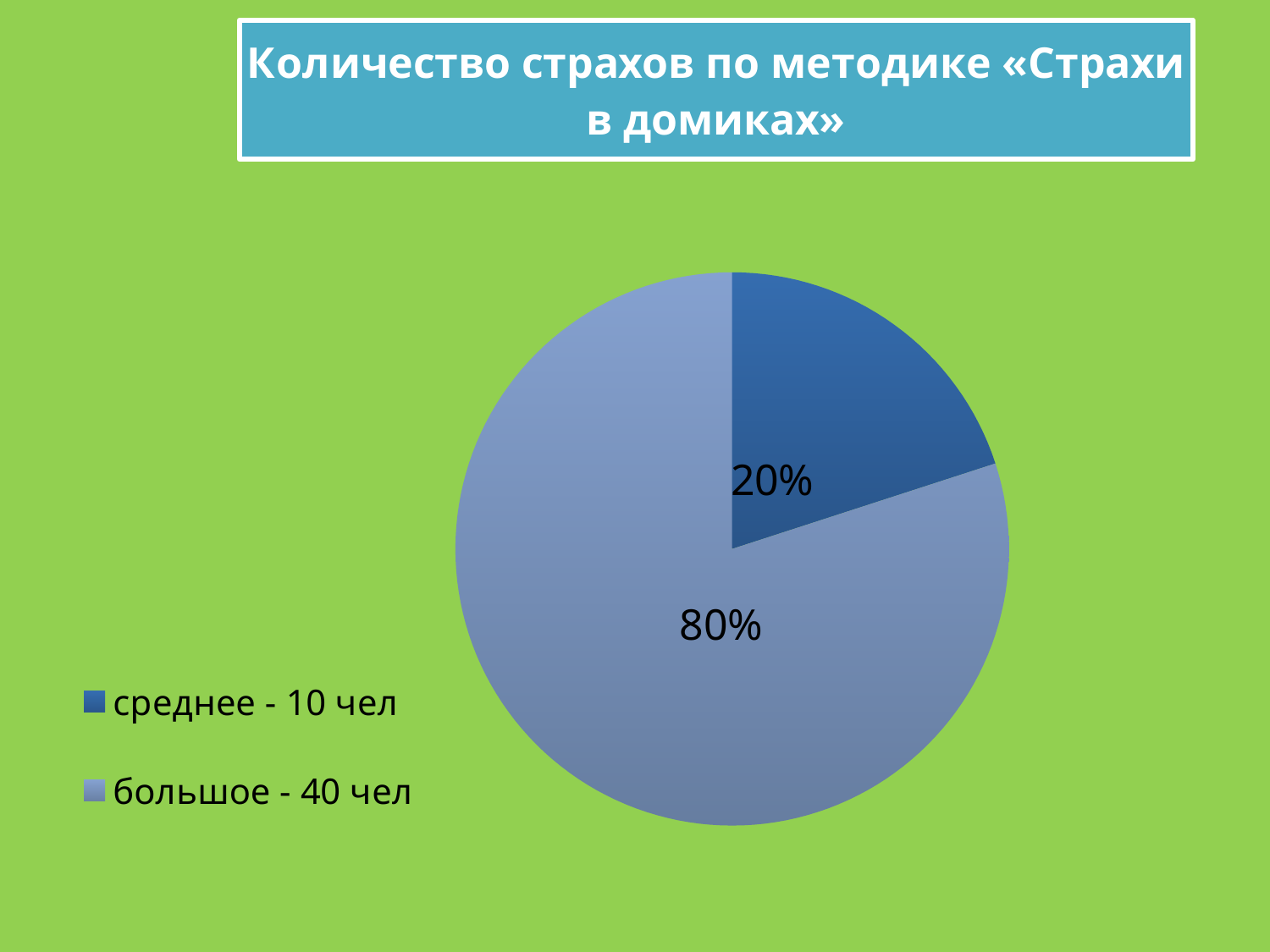
How many entries does the legend list? 2 What kind of chart is shown on the slide? pie chart Which slice is the largest in the pie chart? большое - 40 чел Is the share of the "среднее - 10 чел" slice greater or less than 50%? less What is the title of the chart on the slide? Количество страхов по методике «Страхи в домиках» What share of the pie does the slice "среднее - 10 чел" represent? 20% What share of the pie does the slice "большое - 40 чел" represent? 80% Which slice is the smallest in the pie chart? среднее - 10 чел Which legend entry is shown in the darker blue colour? среднее - 10 чел What is the difference in percentage points between the "большое - 40 чел" slice and the "среднее - 10 чел" slice? 60% How many slices does the pie chart have? 2 Which slice is larger: "среднее - 10 чел" or "большое - 40 чел"? большое - 40 чел